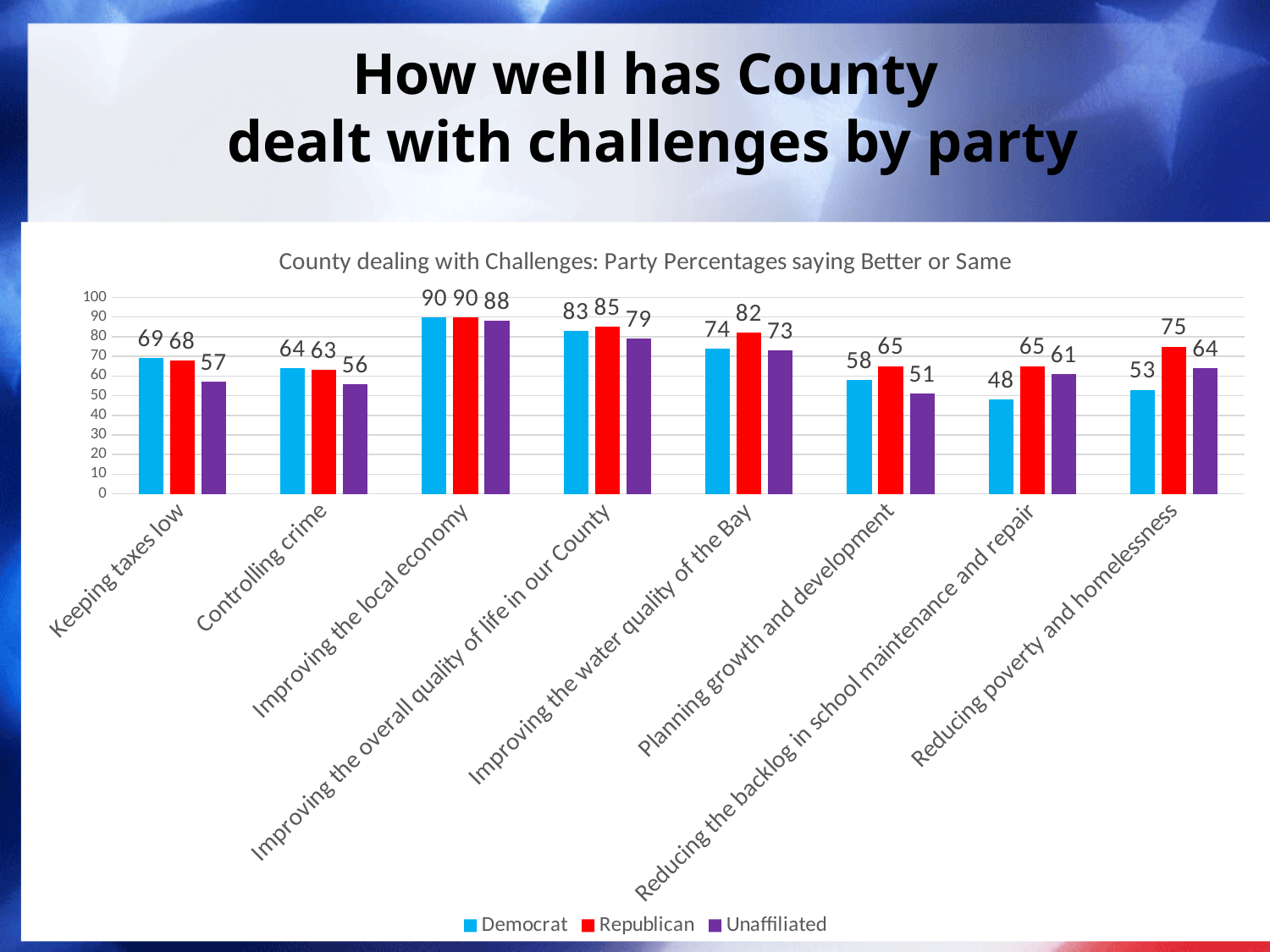
Which is larger for Planning growth and development: the Republican value or the Unaffiliated value? Republican What kind of chart is shown? Bar chart Which category has the highest Unaffiliated value? Improving the local economy How many series does the legend list? 3 Which colour represents the Republican series? Red What is the Republican value for Reducing poverty and homelessness? 75 What is the difference between the Republican and Democrat values for Reducing poverty and homelessness? 22 Which category has the lowest Democrat value? Reducing the backlog in school maintenance and repair What is the title of the chart? County dealing with Challenges: Party Percentages saying Better or Same How many categories are shown on the x axis? 8 What is the Unaffiliated value for Reducing the backlog in school maintenance and repair? 61 What is the Democrat value for Keeping taxes low? 69